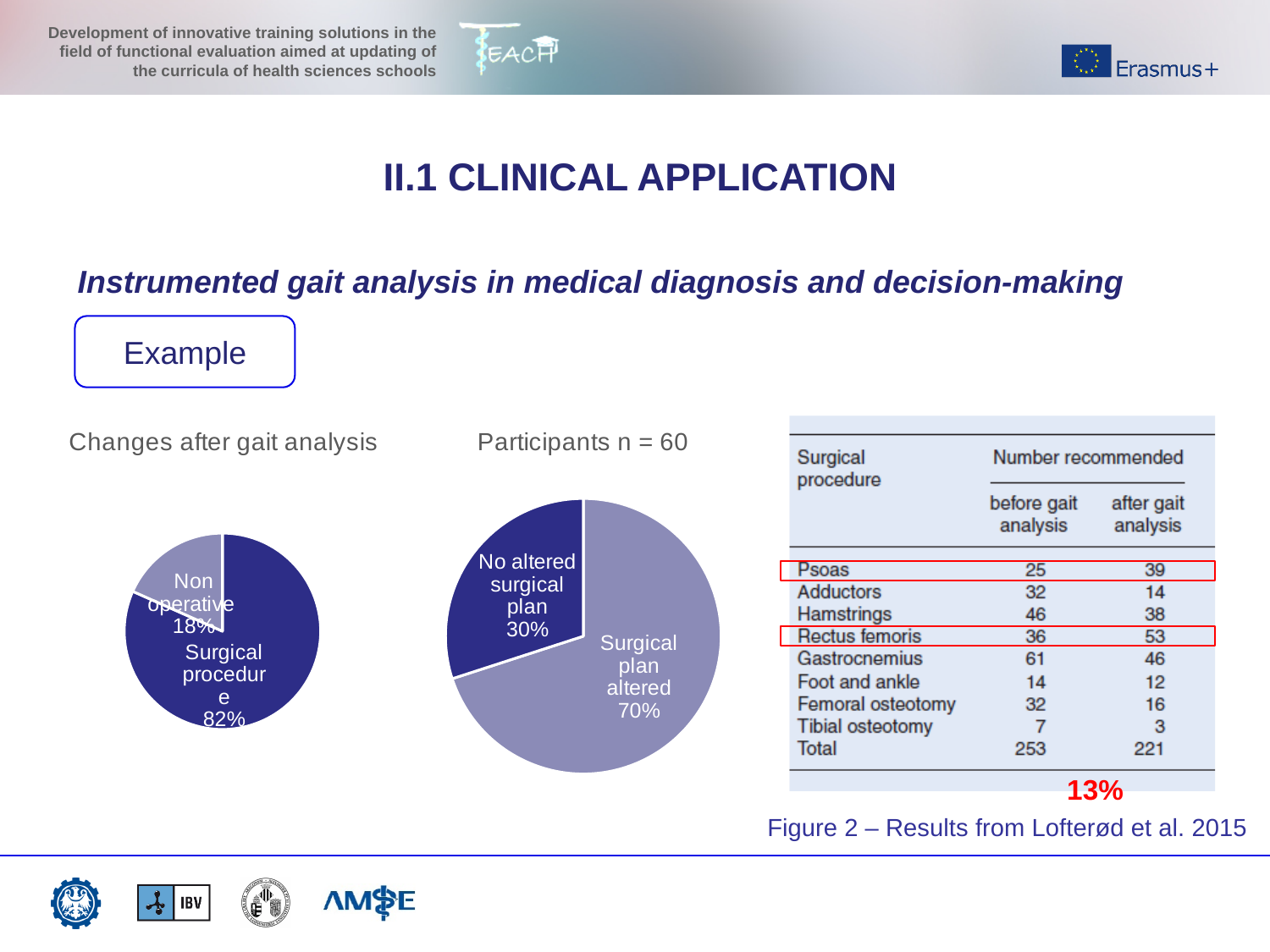
In the left pie chart 'Changes after gait analysis', what share is labelled 'Surgical procedure'? 82% In the middle pie chart 'Participants n = 60', what share is labelled 'No altered surgical plan'? 30% What kind of chart is the middle chart titled 'Participants n = 60'? pie chart In the left pie chart 'Changes after gait analysis', what is the difference in percentage points between 'Surgical procedure' and 'Non operative'? 64 What kind of chart is the left chart titled 'Changes after gait analysis'? pie chart In the middle pie chart 'Participants n = 60', which is larger: 'Surgical plan altered' or 'No altered surgical plan'? Surgical plan altered How many participants does the title of the middle pie chart state? n = 60 In the left pie chart 'Changes after gait analysis', which slice is the largest? Surgical procedure In the left pie chart 'Changes after gait analysis', how many slices are there? 2 In the middle pie chart 'Participants n = 60', what share is labelled 'Surgical plan altered'? 70% In the middle pie chart 'Participants n = 60', which slice is the smallest? No altered surgical plan In the left pie chart 'Changes after gait analysis', what share is labelled 'Non operative'? 18%